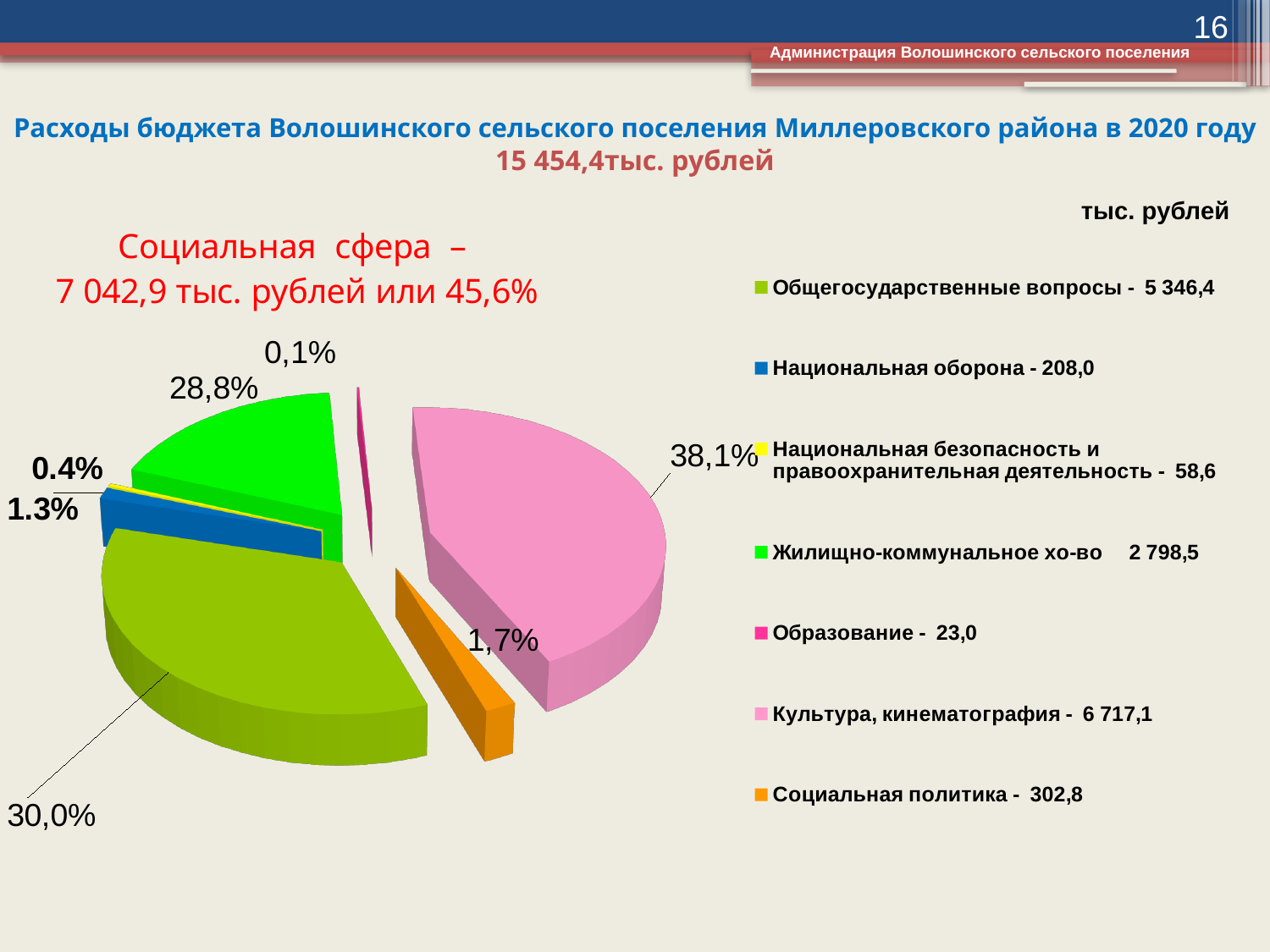
What kind of chart is shown on the slide? pie chart What is the value for Общегосударственные вопросы in the legend? 5 346,4 What unit is stated above the legend for the values? тыс. рублей How many categories does the pie chart's legend list? 7 What is the difference between the values for Культура, кинематография and Общегосударственные вопросы? 1 370,7 What is the value for Культура, кинематография in the legend? 6 717,1 Which category has the largest value? Культура, кинематография What is the value for Социальная политика in the legend? 302,8 What share of the pie does the largest slice (Культура, кинематография) represent, according to its label? 38,1% Which is larger, the value for Национальная оборона or the value for Социальная политика? Социальная политика Which category has the smallest value? Образование What is the value for Жилищно-коммунальное хо-во in the legend? 2 798,5